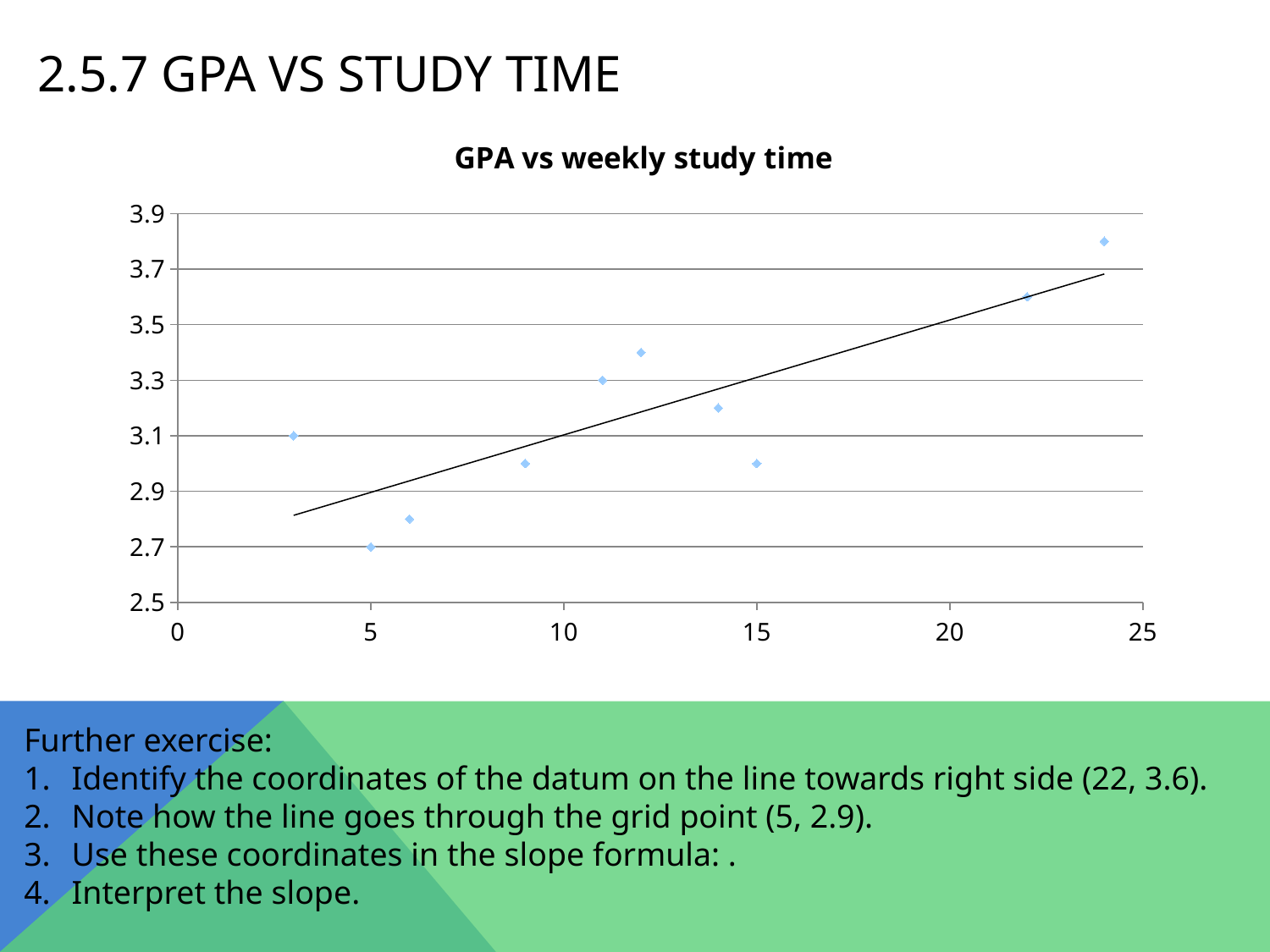
How many data points are plotted on the chart? 10 Do the GPA values generally rise or fall as weekly study time increases along the x axis? rise Is the GPA value for the point at study time 24 greater or less than 3.7? greater What is the title of the chart? GPA vs weekly study time At which study time (x value) is the highest GPA plotted? 24 Is the GPA value for the point at study time 15 greater or less than 3.1? less What is the GPA value of the point at a study time of 11? 3.3 What is the GPA value of the point at a study time of 22? 3.6 What kind of chart is shown on the slide? scatter chart Which point has the higher GPA: the one at study time 12 or the one at study time 14? study time 12 What is the GPA value of the point at a study time of 3? 3.1 At which study time (x value) is the lowest GPA plotted? 5